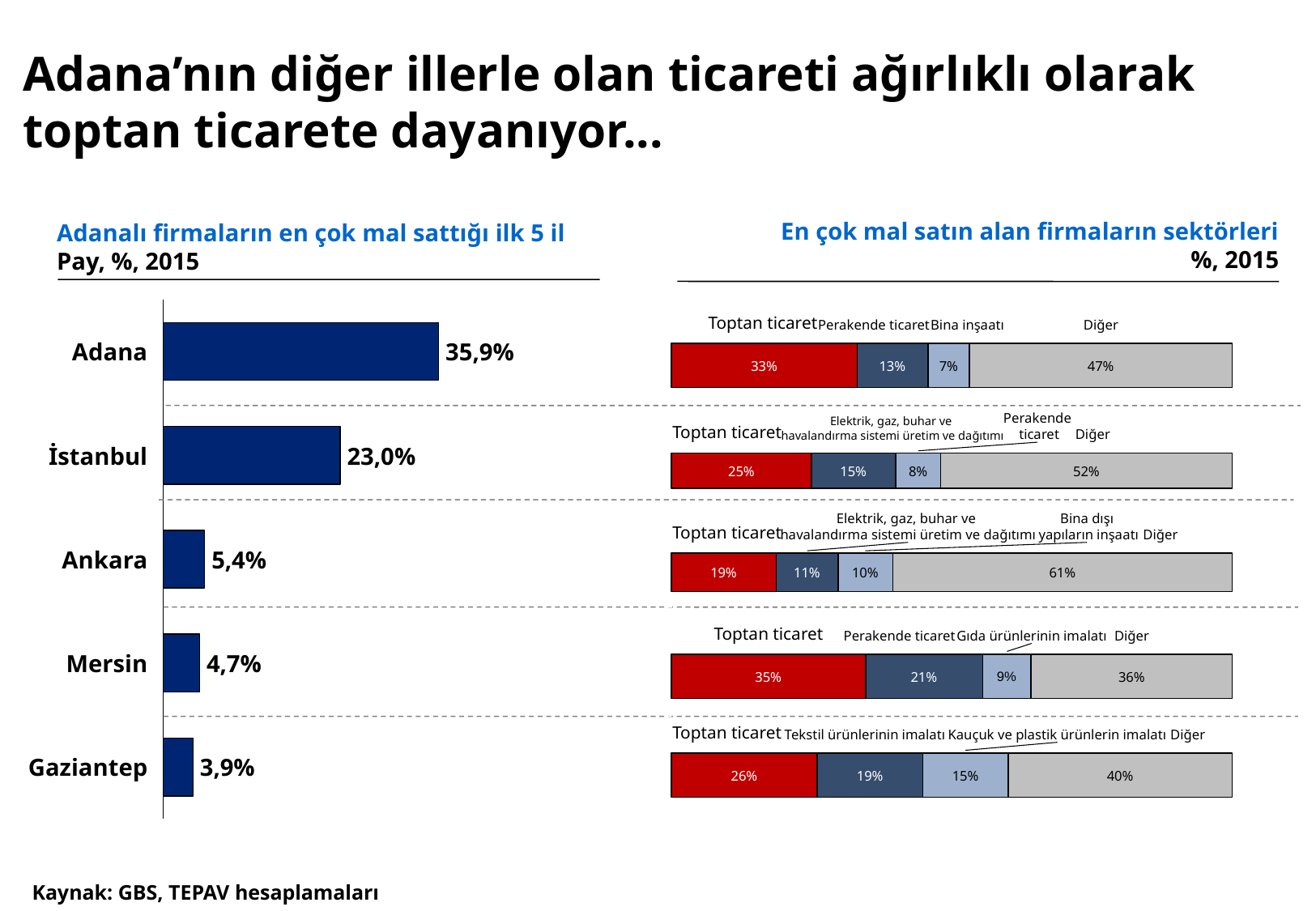
In the left chart 'Adanalı firmaların en çok mal sattığı ilk 5 il', what is the difference between the values for Adana and İstanbul? 12,9 percentage points In the left chart 'Adanalı firmaların en çok mal sattığı ilk 5 il', which is larger, the value for Mersin or the value for Gaziantep? Mersin In the left chart 'Adanalı firmaların en çok mal sattığı ilk 5 il', what is the value for İstanbul? 23,0% In the right chart 'En çok mal satın alan firmaların sektörleri', what is the share of Toptan ticaret for Mersin? 35% In the right chart 'En çok mal satın alan firmaların sektörleri', which province has the highest Toptan ticaret share? Mersin In the right chart 'En çok mal satın alan firmaların sektörleri', what is the difference between the Toptan ticaret shares for Adana and Ankara? 14 percentage points In the right chart 'En çok mal satın alan firmaların sektörleri', what is the share of Diğer for Ankara? 61% In the left chart 'Adanalı firmaların en çok mal sattığı ilk 5 il', which province has the highest share? Adana In the left chart 'Adanalı firmaların en çok mal sattığı ilk 5 il', which province has the lowest share? Gaziantep What kind of chart is the left chart 'Adanalı firmaların en çok mal sattığı ilk 5 il'? Bar chart In the right chart 'En çok mal satın alan firmaların sektörleri', what is the share of Tekstil ürünlerinin imalatı for Gaziantep? 19% In the left chart 'Adanalı firmaların en çok mal sattığı ilk 5 il', how many provinces are shown? 5